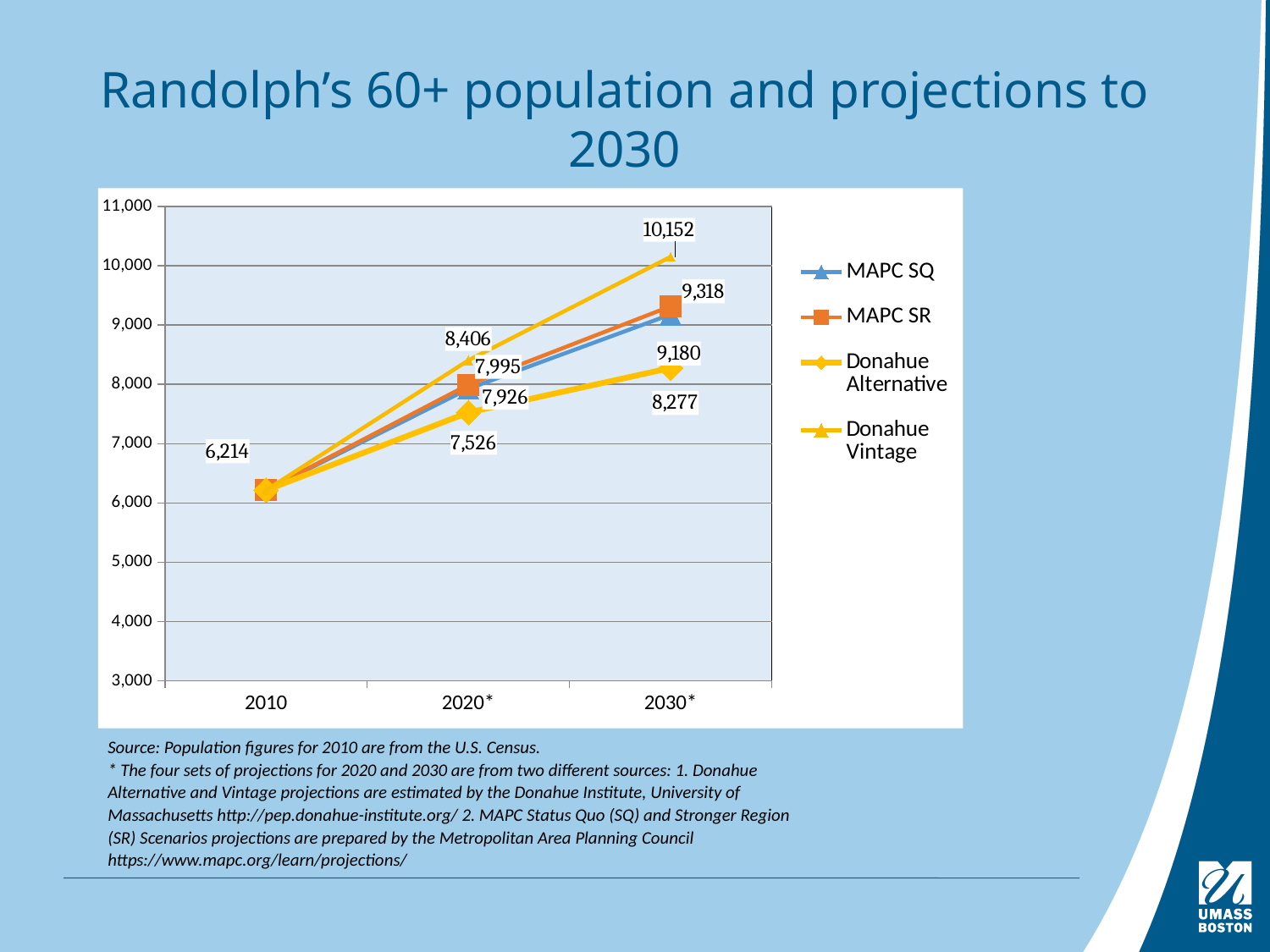
Which series has the lowest projected value for 2030? Donahue Alternative Is the MAPC SR projection for 2030 greater or less than 9,000? greater What is the Donahue Alternative projection for 2030? 8,277 Which series has the highest projected value for 2030? Donahue Vintage What is Randolph's 60+ population in 2010? 6,214 Do the projected values rise or fall from 2010 to 2030? rise What is the difference between the highest and lowest projections for 2030? 1,875 How many series does the legend list? 4 How many years are shown on the x axis? 3 What type of chart is shown on the slide? line chart What is the MAPC SR projection for 2030? 9,318 What is the Donahue Vintage projection for 2030? 10,152